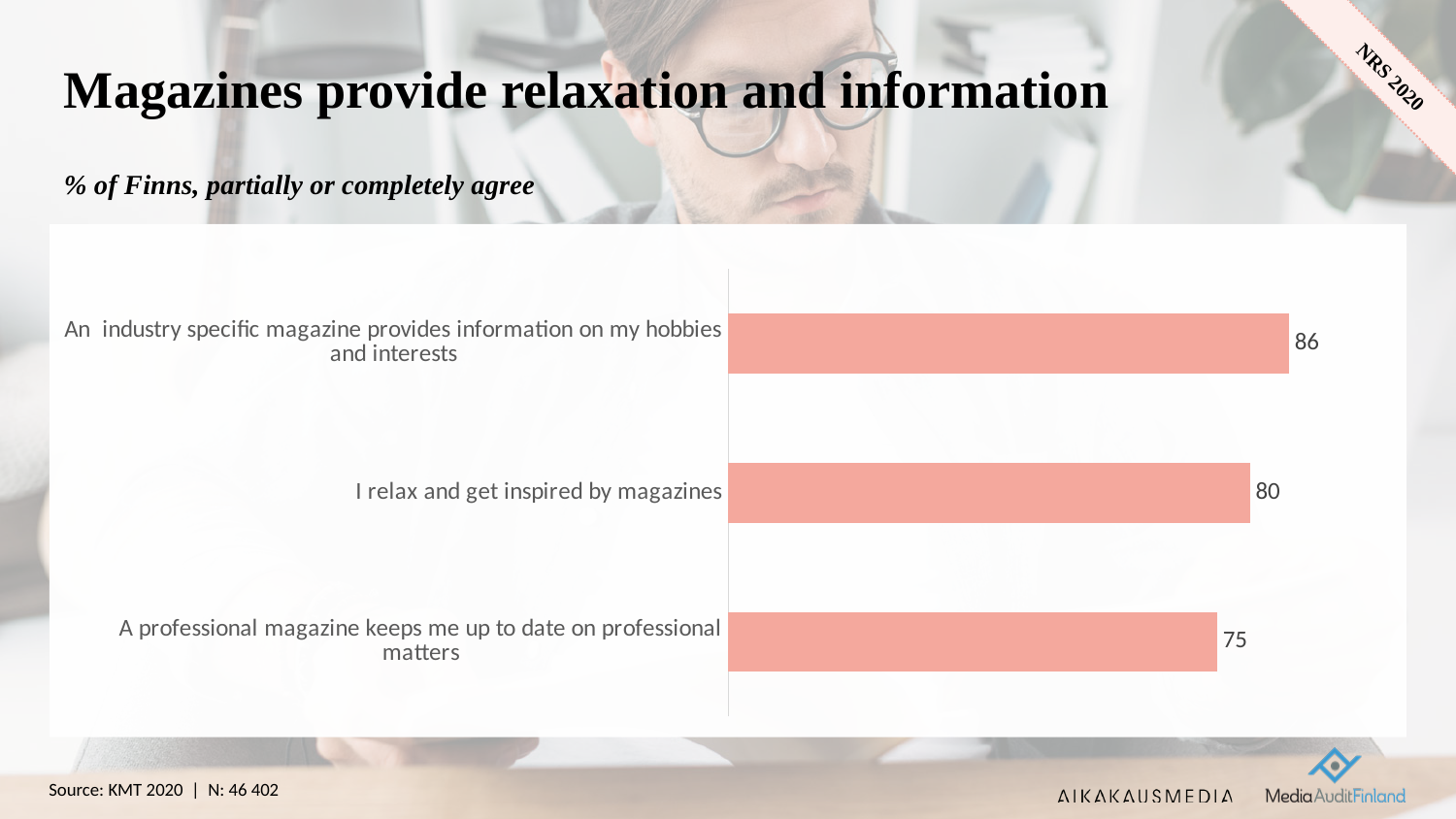
What is the source cited for the chart data? KMT 2020 What is the value for "A professional magazine keeps me up to date on professional matters"? 75 What percentage of Finns agree that an industry specific magazine provides information on their hobbies and interests? 86 What is the title of the slide? Magazines provide relaxation and information How many statements are shown in the chart? 3 What is the difference between the values for the industry specific magazine statement and the professional magazine statement? 11 Which has a larger value: "I relax and get inspired by magazines" or "A professional magazine keeps me up to date on professional matters"? I relax and get inspired by magazines What is the value for "I relax and get inspired by magazines"? 80 What kind of chart is shown on the slide? Bar chart Which statement has the lowest share of agreement? A professional magazine keeps me up to date on professional matters Which statement has the highest share of agreement? An industry specific magazine provides information on my hobbies and interests What is the difference between the values for "I relax and get inspired by magazines" and "A professional magazine keeps me up to date on professional matters"? 5